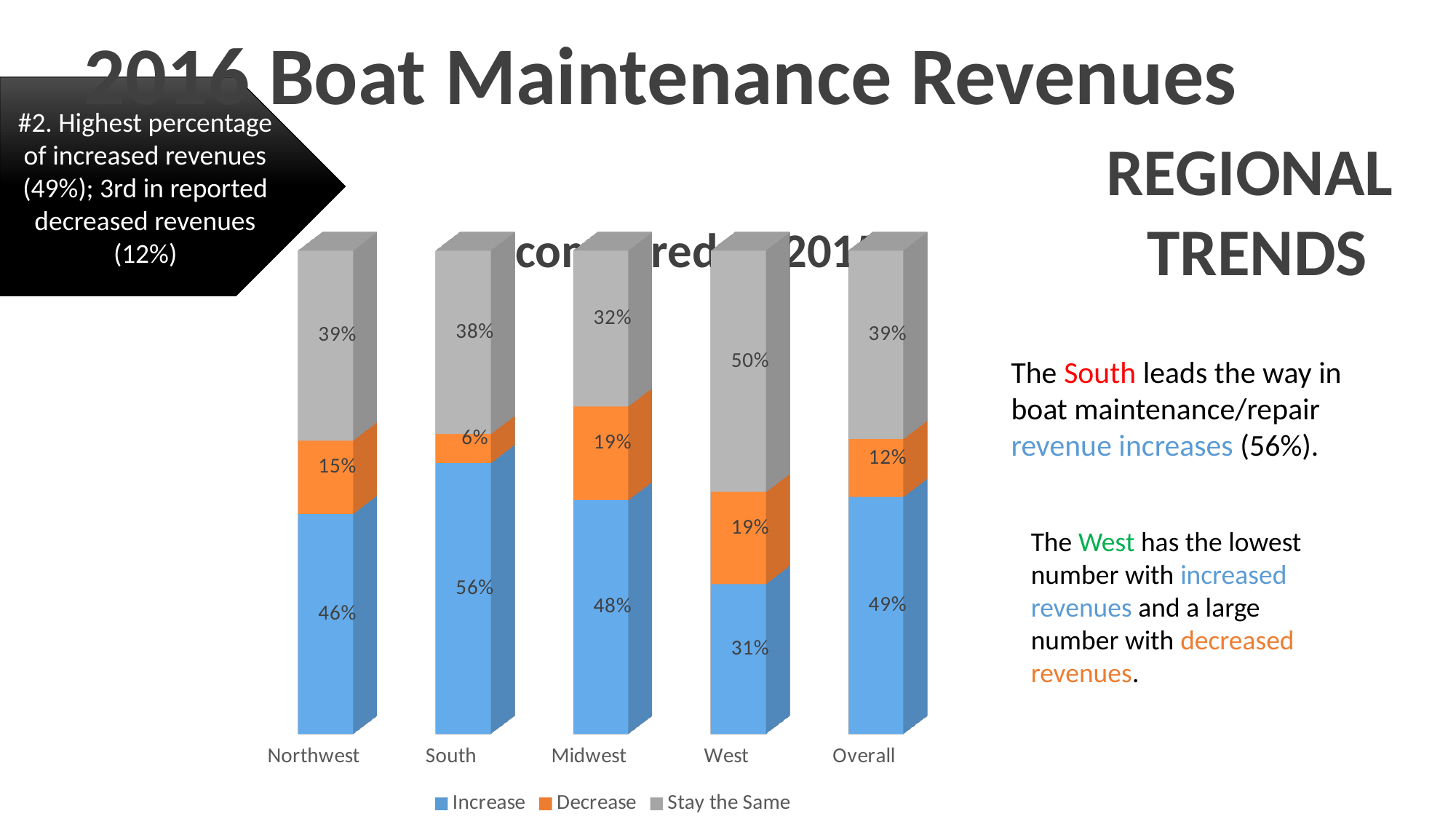
Which colour represents the Decrease series in the legend? Orange What is the Stay the Same value for the West? 50% How many series does the legend list? 3 Which region has the lowest Decrease value? South Which is larger, the Stay the Same value for the Midwest or for the Northwest? Northwest What is the Increase value for Overall? 49% What kind of chart is shown? Stacked bar chart Which region has the highest Increase value? South What is the Decrease value for the Northwest? 15% How many categories are shown on the x axis? 5 What is the difference between the Increase values for the South and the West? 25% What is the Increase value for the South? 56%